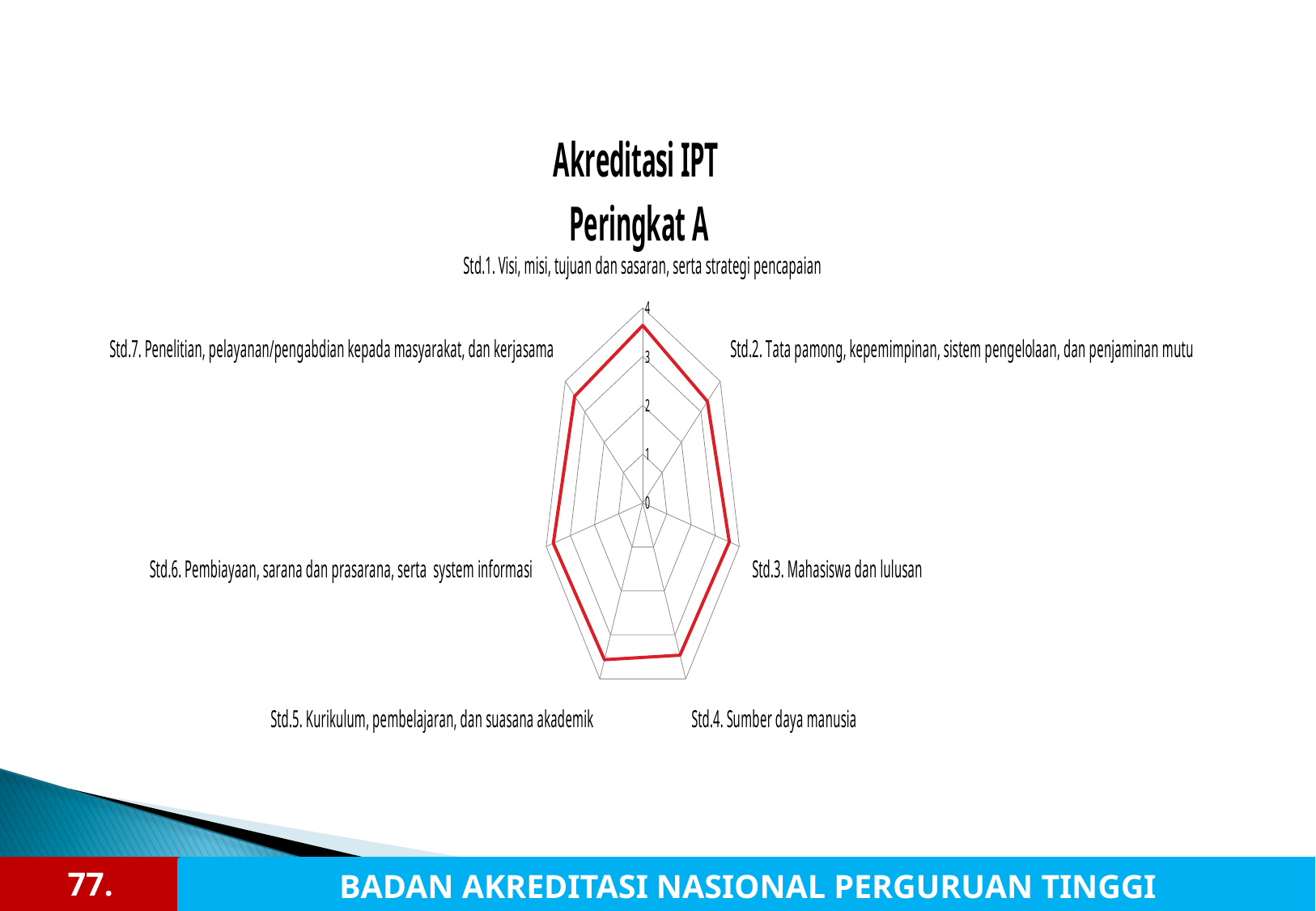
What is the title of the chart? Akreditasi IPT Peringkat A How many categories (standards) are plotted on the radar chart? 7 Is the value for Std.3. Mahasiswa dan lulusan greater or less than 3? greater Is the value for Std.4. Sumber daya manusia greater or less than 1? greater What kind of chart is shown on the slide? Radar chart Is the value for Std.6. Pembiayaan, sarana dan prasarana, serta system informasi greater or less than 3? greater What is the highest tick value shown on the radar chart's axis? 4